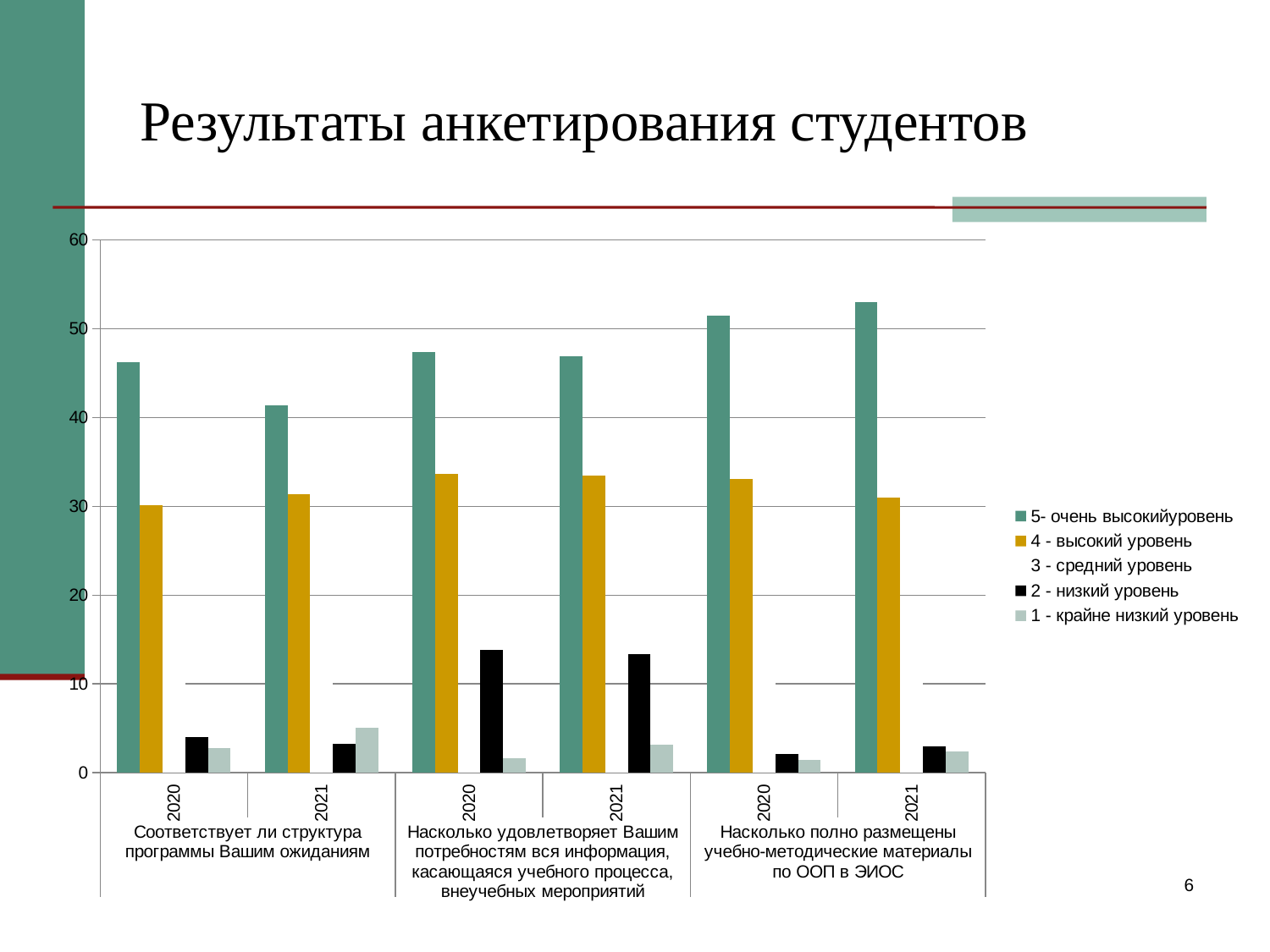
Is the value for '1 - крайне низкий уровень' in 2021 for 'Соответствует ли структура программы Вашим ожиданиям' greater or less than 10? less Is the value for '2 - низкий уровень' in 2020 for 'Насколько удовлетворяет Вашим потребностям вся информация, касающаяся учебного процесса, внеучебных мероприятий' greater or less than 10? greater What kind of chart is shown on the slide? bar chart Which series is shown in black in the legend? 2 - низкий уровень For 'Насколько полно размещены учебно-методические материалы по ООП в ЭИОС' in 2021, which is larger: '5- очень высокий уровень' or '4 - высокий уровень'? 5- очень высокий уровень Is the value for '5- очень высокий уровень' in 2020 for 'Соответствует ли структура программы Вашим ожиданиям' greater or less than 40? greater Which years are compared for each survey question? 2020 and 2021 How many series does the legend list? 5 Does the value for '5- очень высокий уровень' rise or fall from 2020 to 2021 for 'Соответствует ли структура программы Вашим ожиданиям'? fall For 'Соответствует ли структура программы Вашим ожиданиям', which year has the larger value for '5- очень высокий уровень', 2020 or 2021? 2020 How many survey questions (category groups) are shown along the x axis? 3